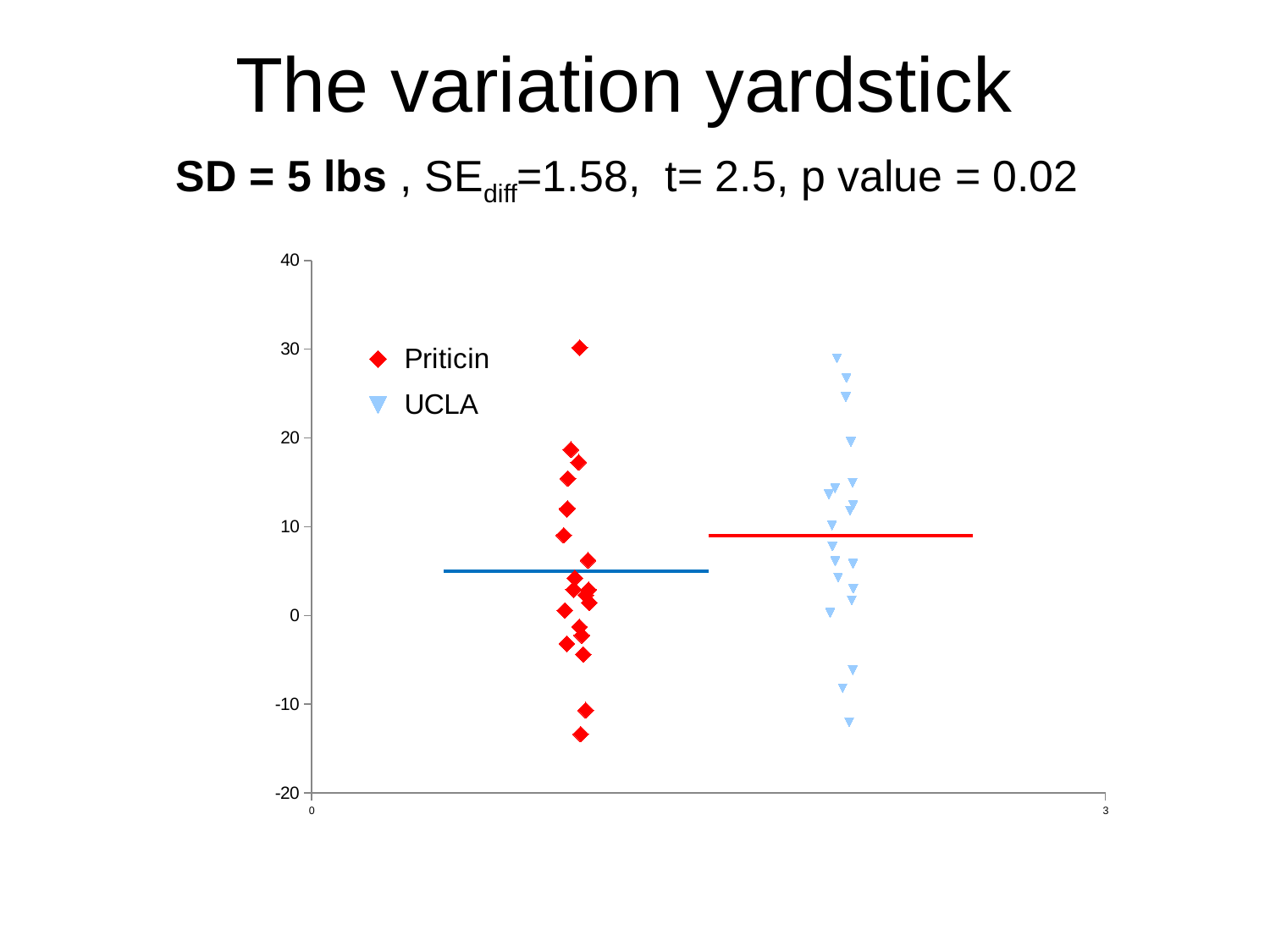
Is the red horizontal line over the UCLA points greater or less than 10? less Is the blue horizontal line over the Priticin points greater or less than 0? greater Is the highest Priticin point greater or less than 20? greater What is the highest value shown on the y axis? 40 What kind of chart is shown on the slide? scatter chart What are the two series named in the legend? Priticin and UCLA How many series does the legend list? 2 Which horizontal line sits higher on the y axis, the blue line over the Priticin points or the red line over the UCLA points? the red line over the UCLA points